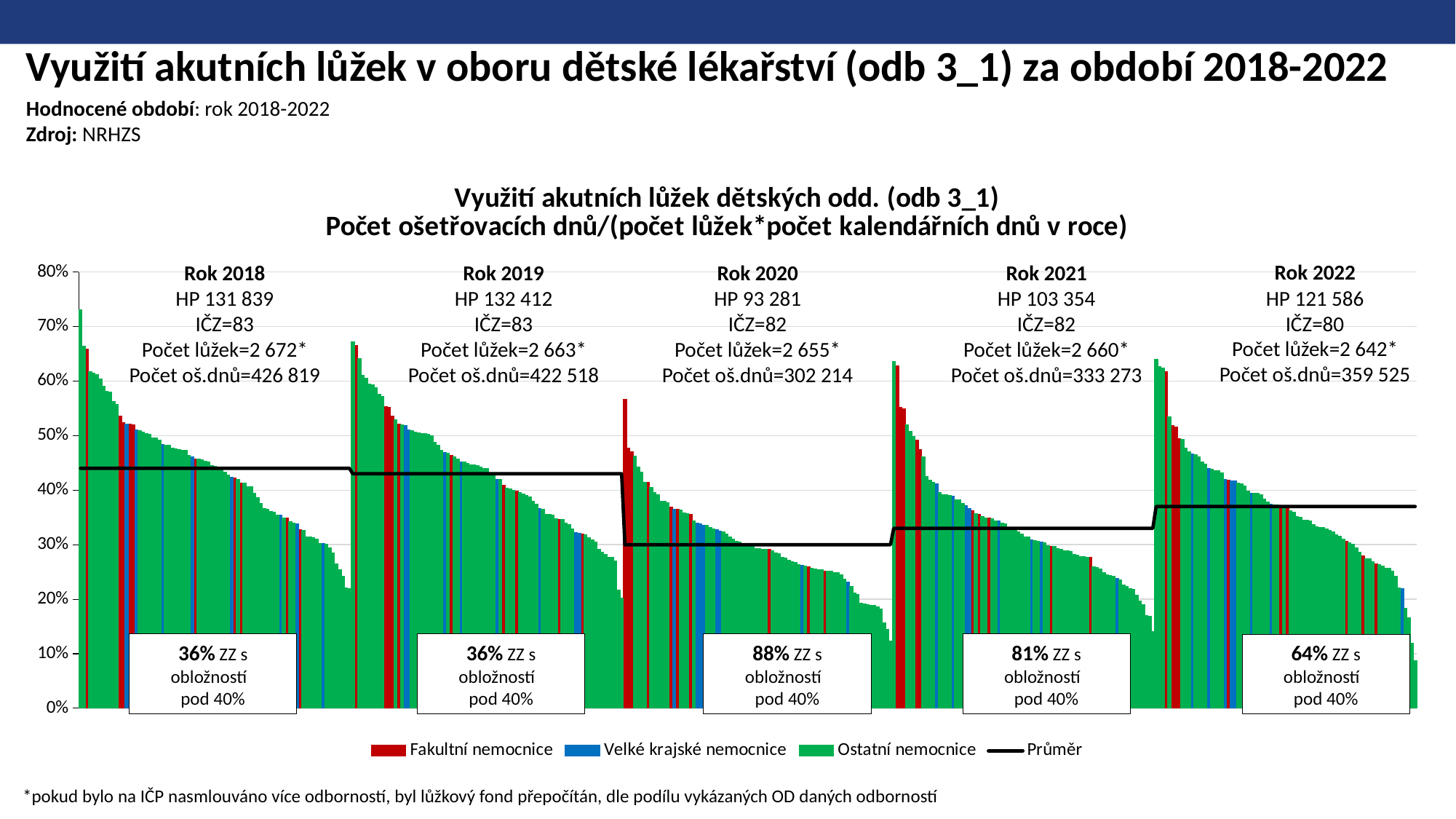
What percentage of ZZ had obložnost pod 40% in Rok 2022? 64% Which year has the highest share of ZZ s obložností pod 40%? Rok 2020 How many entries does the chart legend list? 4 Which legend entry is shown in red? Fakultní nemocnice What is the difference between the share of ZZ s obložností pod 40% in Rok 2020 and in Rok 2018? 52 percentage points Is the Průměr line for Rok 2020 greater or less than 40%? less Is the Počet oš.dnů larger in Rok 2018 or in Rok 2022? Rok 2018 What is the HP value shown for Rok 2020? 93 281 What is the Počet lůžek shown for Rok 2019? 2 663* What is the Počet oš.dnů shown for Rok 2021? 333 273 What kind of chart is shown on the slide? combination bar and line chart Which year has the lowest IČZ value? Rok 2022